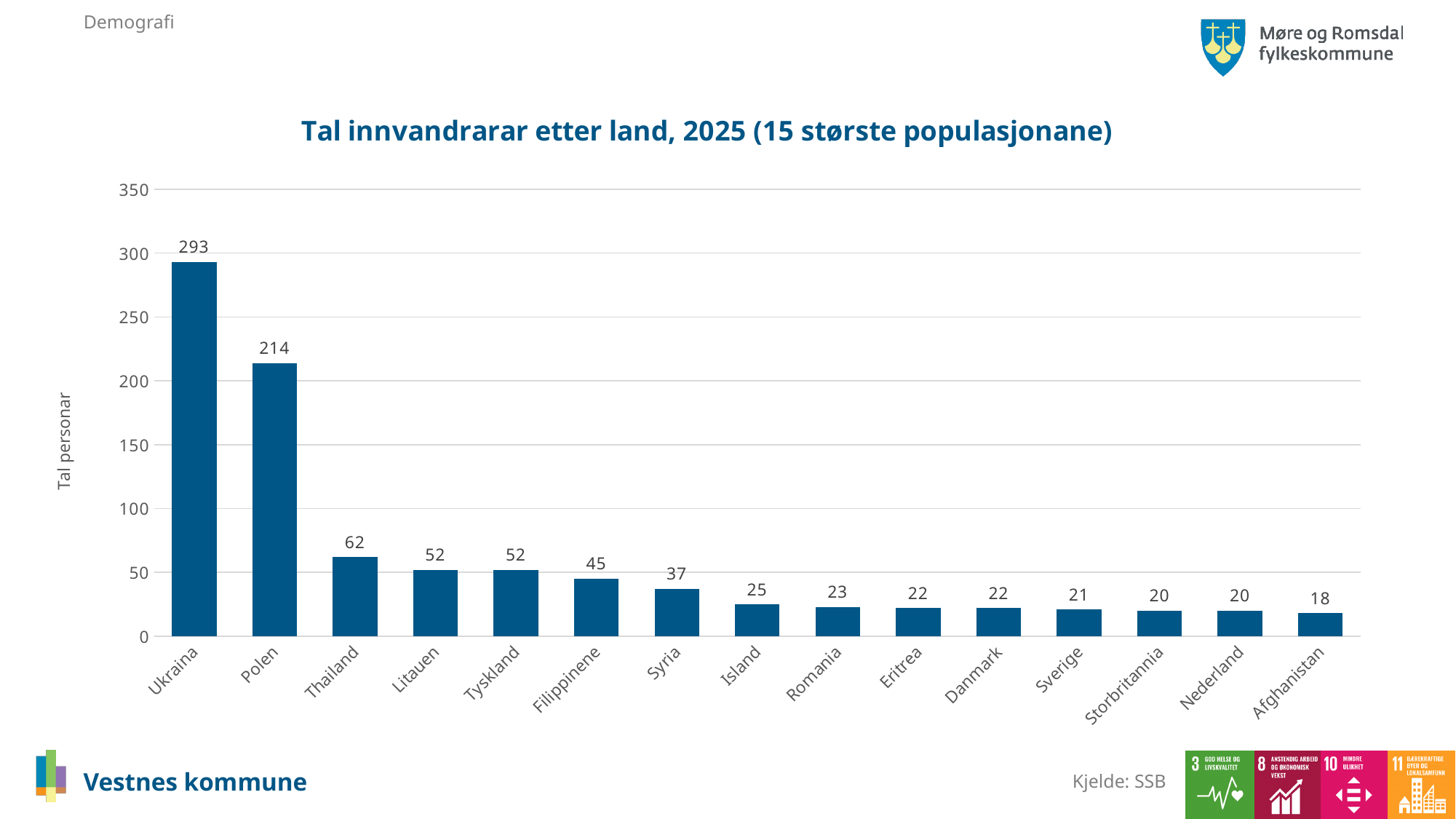
What is the value for Afghanistan? 18 What is the value for Ukraina? 293 What kind of chart is this? bar chart What is the value for Filippinene? 45 Which country has the lowest value? Afghanistan What is the difference between the values for Ukraina and Polen? 79 How many countries are shown on the chart? 15 Do the values rise or fall from left to right along the x axis? fall What is the title of the chart? Tal innvandrarar etter land, 2025 (15 største populasjonane) Which country has the highest value? Ukraina What is the difference between the values for Thailand and Syria? 25 Which is larger, the value for Polen or the value for Thailand? Polen